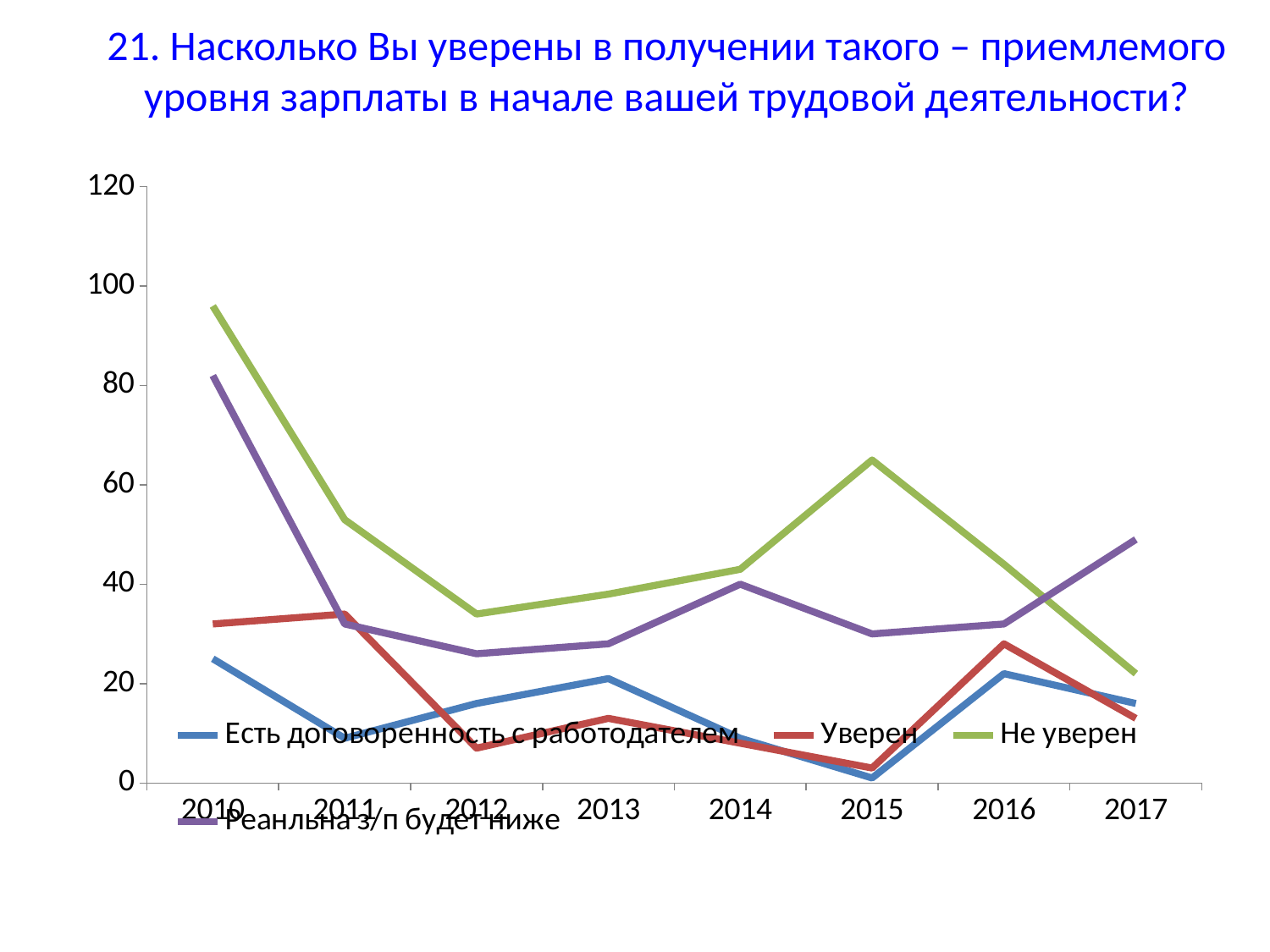
In which year is the value for "Не уверен" lowest? 2017 How many series does the legend list? 4 Is the value for "Не уверен" in 2010 greater or less than 80? greater In which year is the value for "Не уверен" highest? 2010 Does the value for "Не уверен" rise or fall from 2010 to 2012? fall Is the value for "Уверен" in 2015 greater or less than 20? less In 2017, which is larger: "Реанльна з/п будет ниже" or "Не уверен"? Реанльна з/п будет ниже How many years are plotted along the x axis? 8 In 2015, which is larger: "Не уверен" or "Уверен"? Не уверен What kind of chart is shown on the slide? line chart Which series has the highest value in 2010? Не уверен Is the value for "Реанльна з/п будет ниже" in 2017 greater or less than 40? greater